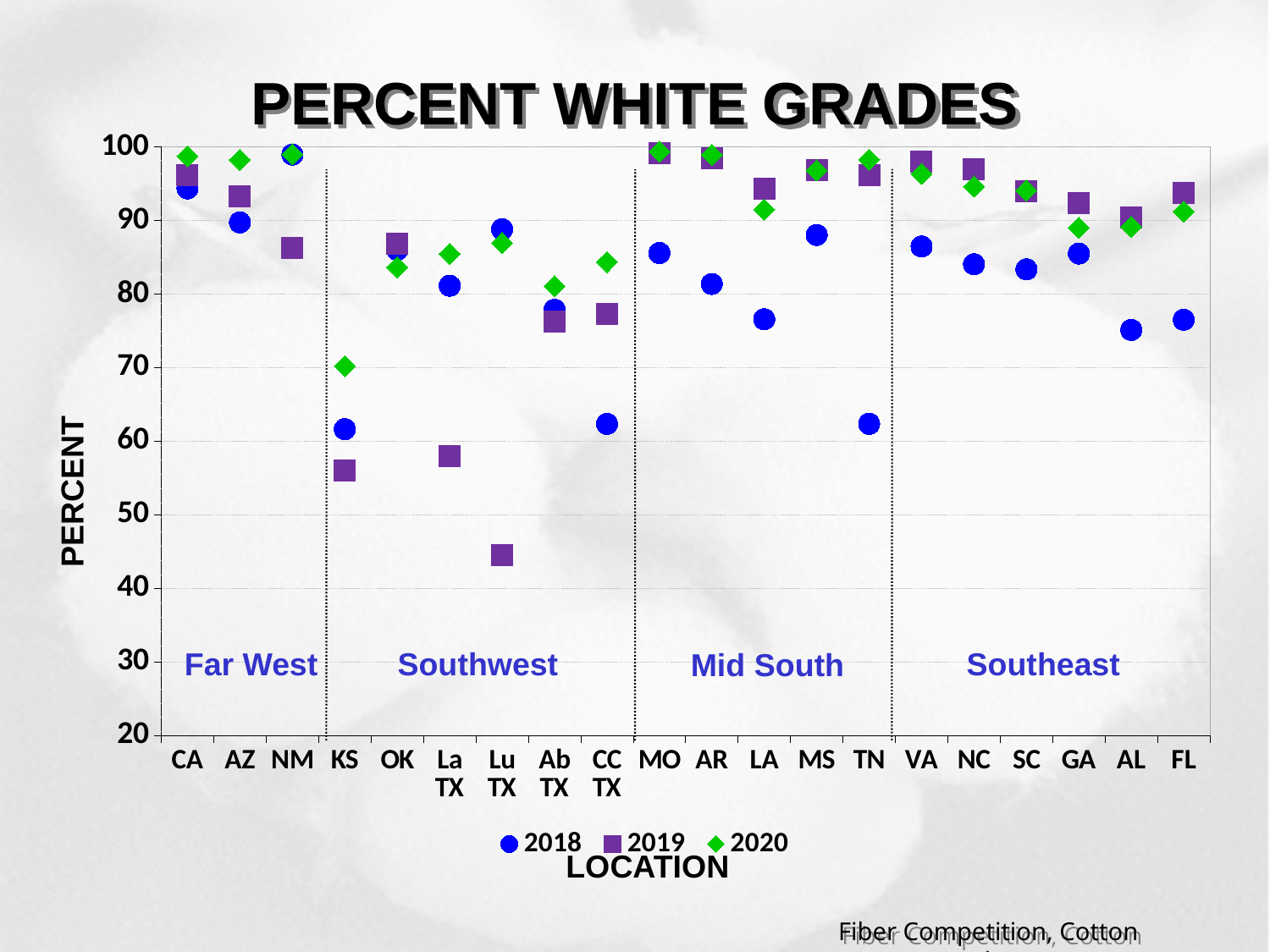
What is the title of the chart? PERCENT WHITE GRADES Is the 2019 value for KS greater or less than 60? less Which location has the lowest 2020 value? KS What kind of chart is shown on the slide? scatter chart How many series does the legend list? 3 Is the 2019 value for Lu TX greater or less than 50? less Which location has the lowest 2019 value? Lu TX For TN, which is larger: the 2018 value or the 2019 value? 2019 Is the 2019 value for MO greater or less than 90? greater For KS, which is larger: the 2019 value or the 2020 value? 2020 How many locations are shown along the x axis? 20